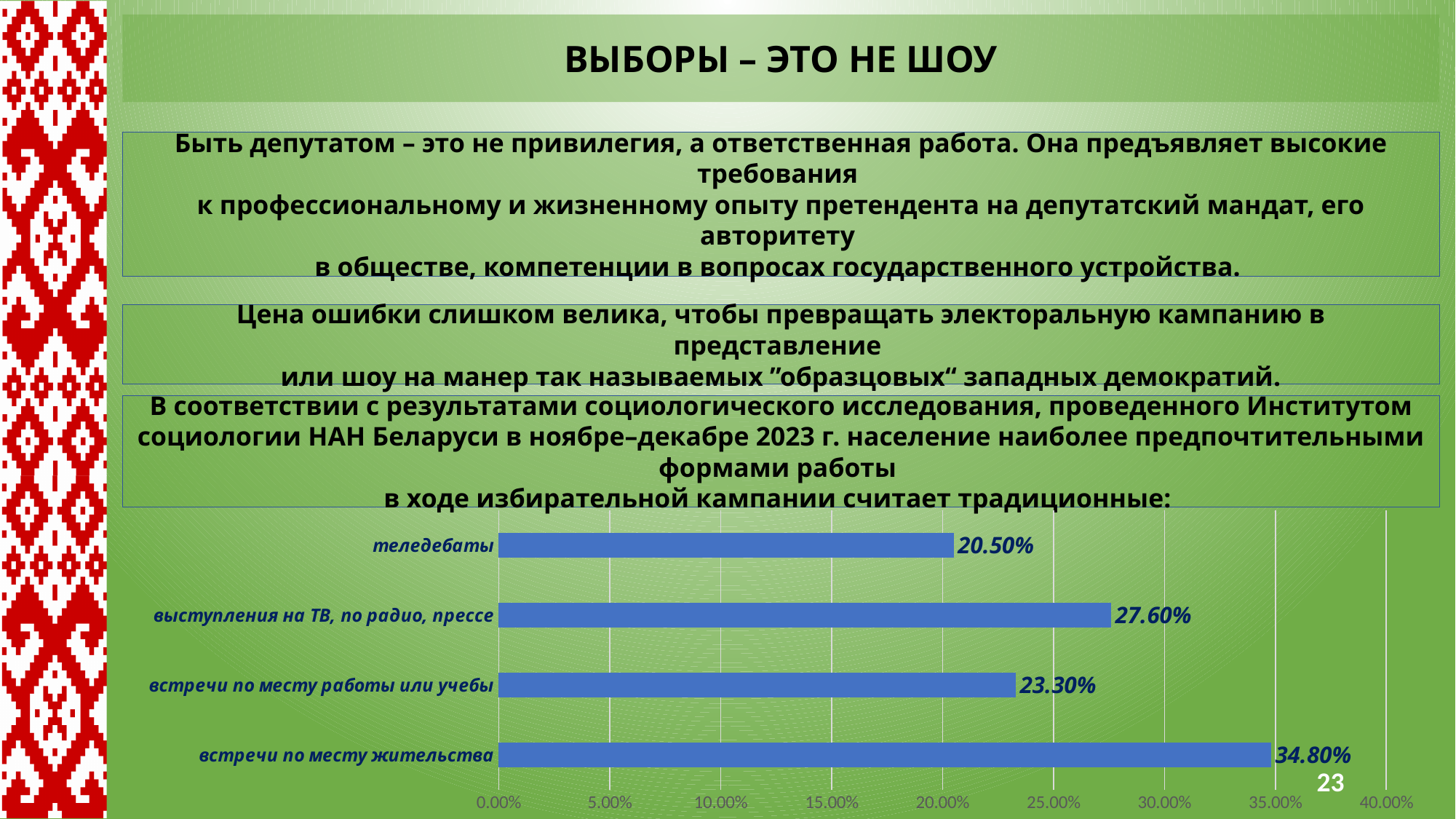
Which category has the highest value? встречи по месту жительства What is the value for встречи по месту жительства? 34.80% Which category has the lowest value? теледебаты What is the value for теледебаты? 20.50% What is the value for встречи по месту работы или учебы? 23.30% What is the value for выступления на ТВ, по радио, прессе? 27.60% What is the difference between the values for встречи по месту жительства and теледебаты? 14.30% What is the difference between the values for выступления на ТВ, по радио, прессе and встречи по месту работы или учебы? 4.30% How many categories are shown in the chart? 4 Which is larger: the value for выступления на ТВ, по радио, прессе or the value for встречи по месту работы или учебы? выступления на ТВ, по радио, прессе What kind of chart is shown on the slide? bar chart Is the value for встречи по месту жительства greater or less than 30.00%? greater